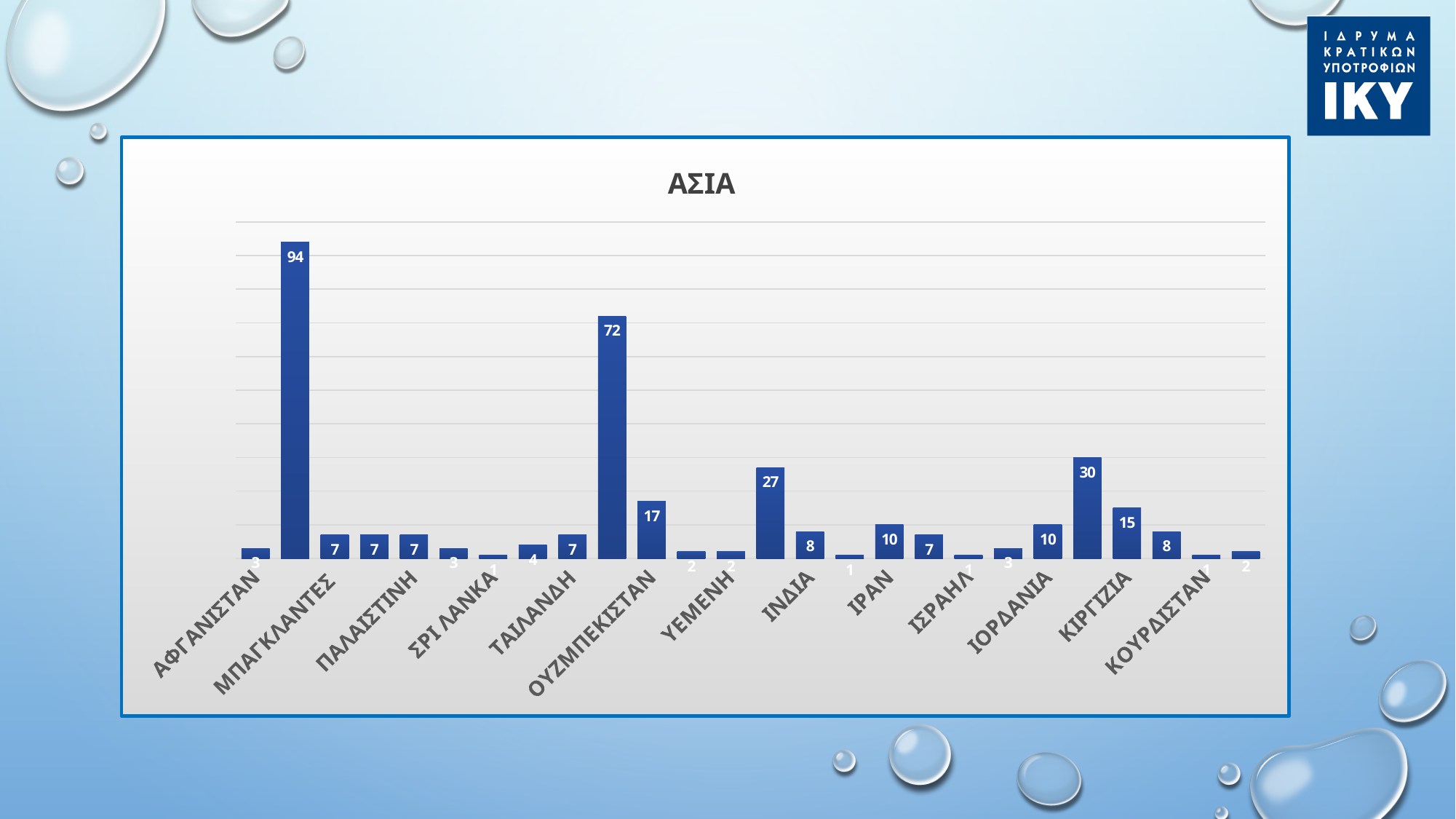
What is the highest value shown in the chart? 94 What is the lowest value shown in the chart? 1 How many bars have a value of 1? 4 How many bars have a value greater than 50? 2 Which is larger, the bar labelled 30 or the bar labelled 27? 30 What is the difference between the two tallest bars (94 and 72)? 22 What kind of chart is shown on the slide? bar chart What is the second highest value shown in the chart? 72 What is the title of the chart? ΑΣΙΑ How many bars are plotted in the chart? 26 What is the value of the first bar, labelled ΑΦΓΑΝΙΣΤΑΝ? 3 What colour are the bars in the chart? blue